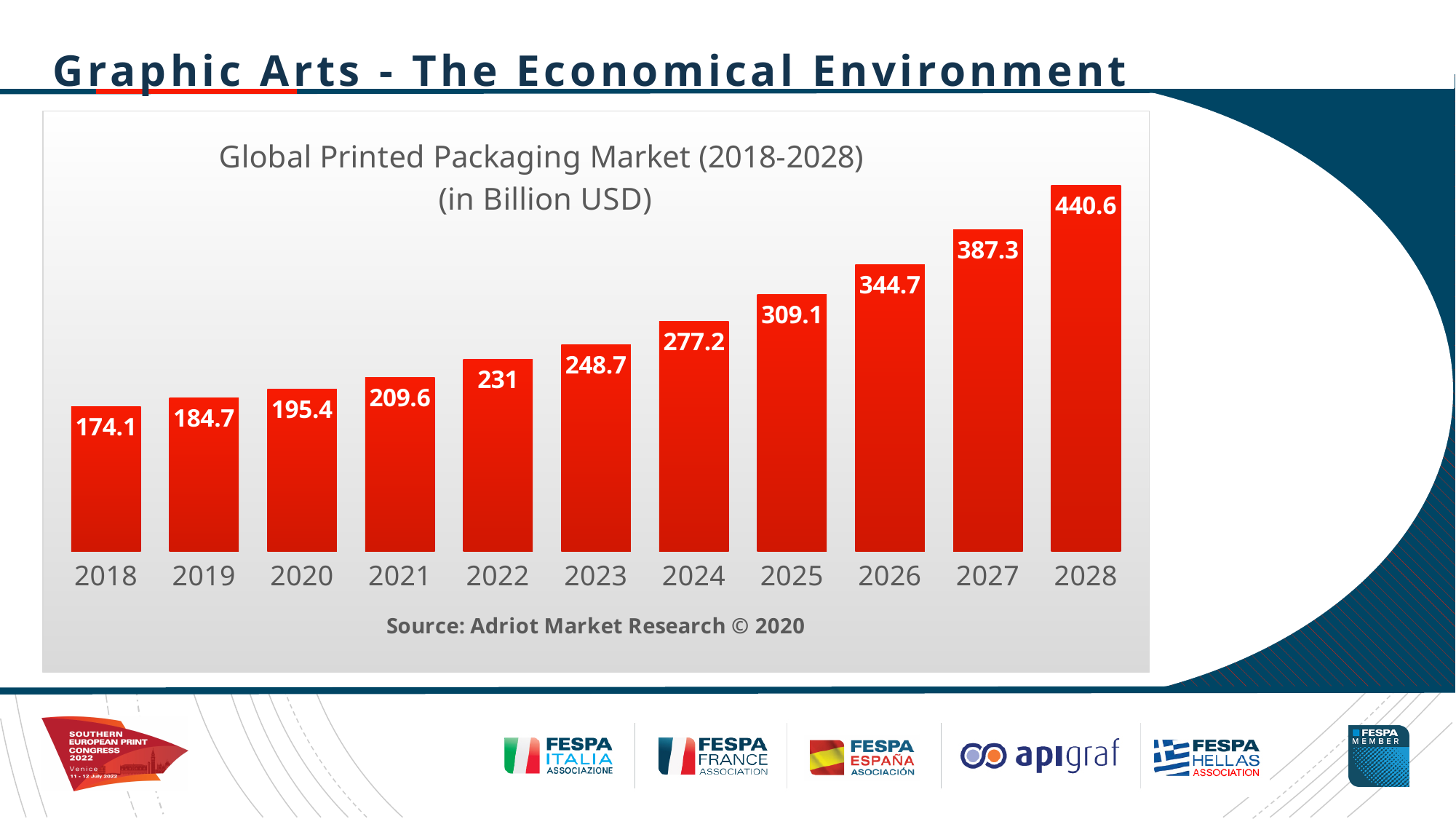
What is the value for 2018? 174.1 Which year has the highest value? 2028 What kind of chart is this? bar chart Do the values rise or fall from 2018 to 2028? rise What is the title of the chart? Global Printed Packaging Market (2018-2028) (in Billion USD) Which is larger, the value for 2021 or the value for 2023? 2023 Which year has the lowest value? 2018 How many years are shown on the x axis? 11 What is the value for 2024? 277.2 What is the difference between the values for 2027 and 2026? 42.6 What is the difference between the values for 2028 and 2018? 266.5 What is the value for 2022? 231